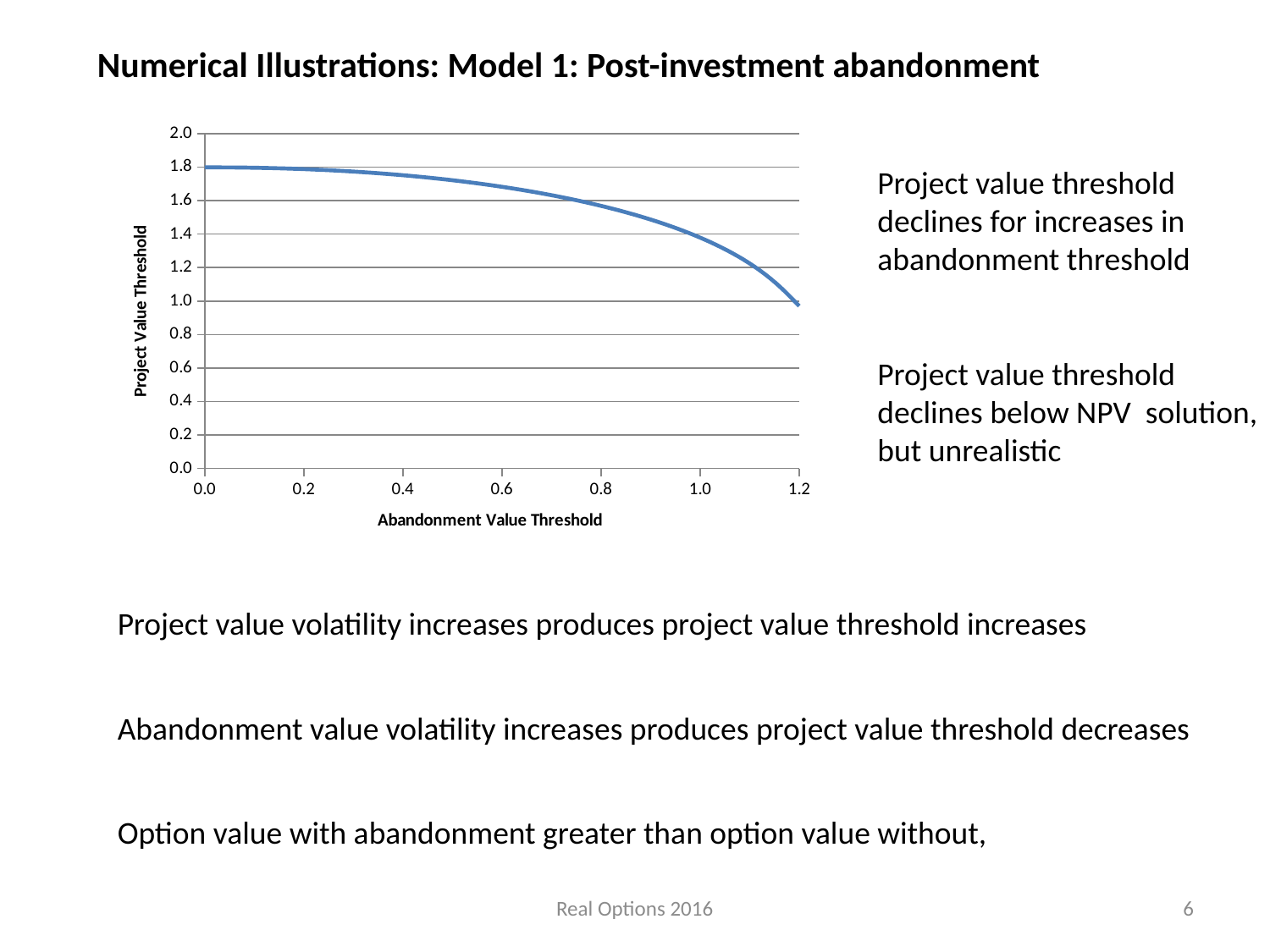
Is the Project Value Threshold at an Abandonment Value Threshold of 0.0 greater or less than 1.6? greater Is the Project Value Threshold at an Abandonment Value Threshold of 0.8 greater or less than 1.2? greater Is the Project Value Threshold at an Abandonment Value Threshold of 1.2 greater or less than 1.2? less What kind of chart is shown on the slide? line chart Is the Project Value Threshold larger at an Abandonment Value Threshold of 0.2 or of 1.0? 0.2 Which Abandonment Value Threshold shown on the x axis gives the lowest Project Value Threshold? 1.2 What is the title of the y axis of the chart? Project Value Threshold What is the title of the x axis of the chart? Abandonment Value Threshold Which Abandonment Value Threshold shown on the x axis gives the highest Project Value Threshold? 0.0 Does the Project Value Threshold rise or fall as the Abandonment Value Threshold increases along the x axis? fall